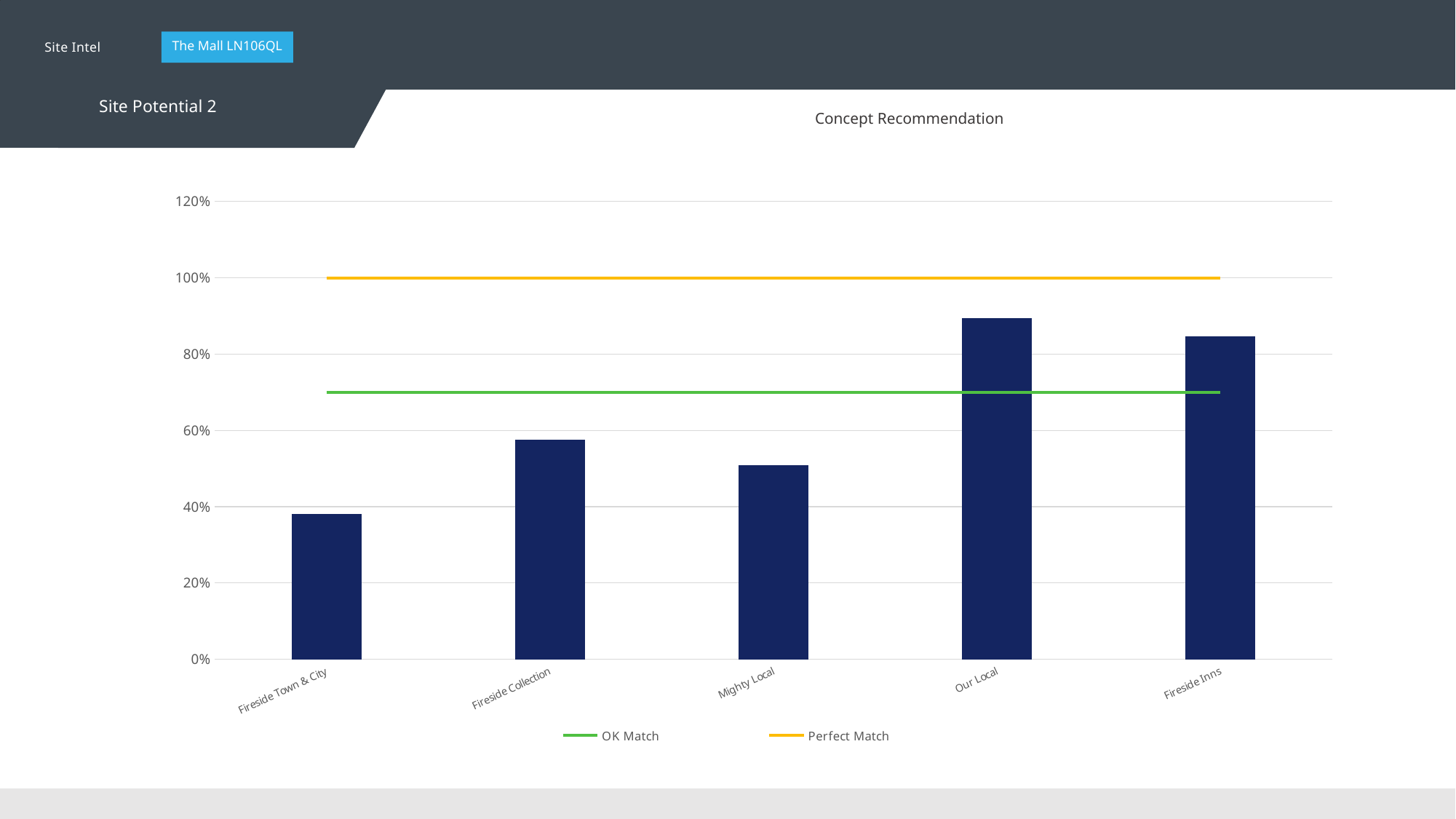
Is the value for Our Local greater or less than 80%? greater Which concept has the highest bar? Our Local Is the value for Fireside Town & City greater or less than 40%? less How many concept categories are plotted on the x axis? 5 At what level does the Perfect Match line sit on the y axis? 100% Which concept has the lowest bar? Fireside Town & City How many entries does the legend list? 2 Is the value for Mighty Local greater or less than 40%? greater What is the title of the chart? Concept Recommendation What type of chart is shown on the slide? Combination bar and line chart Which is larger, the value for Fireside Collection or the value for Mighty Local? Fireside Collection